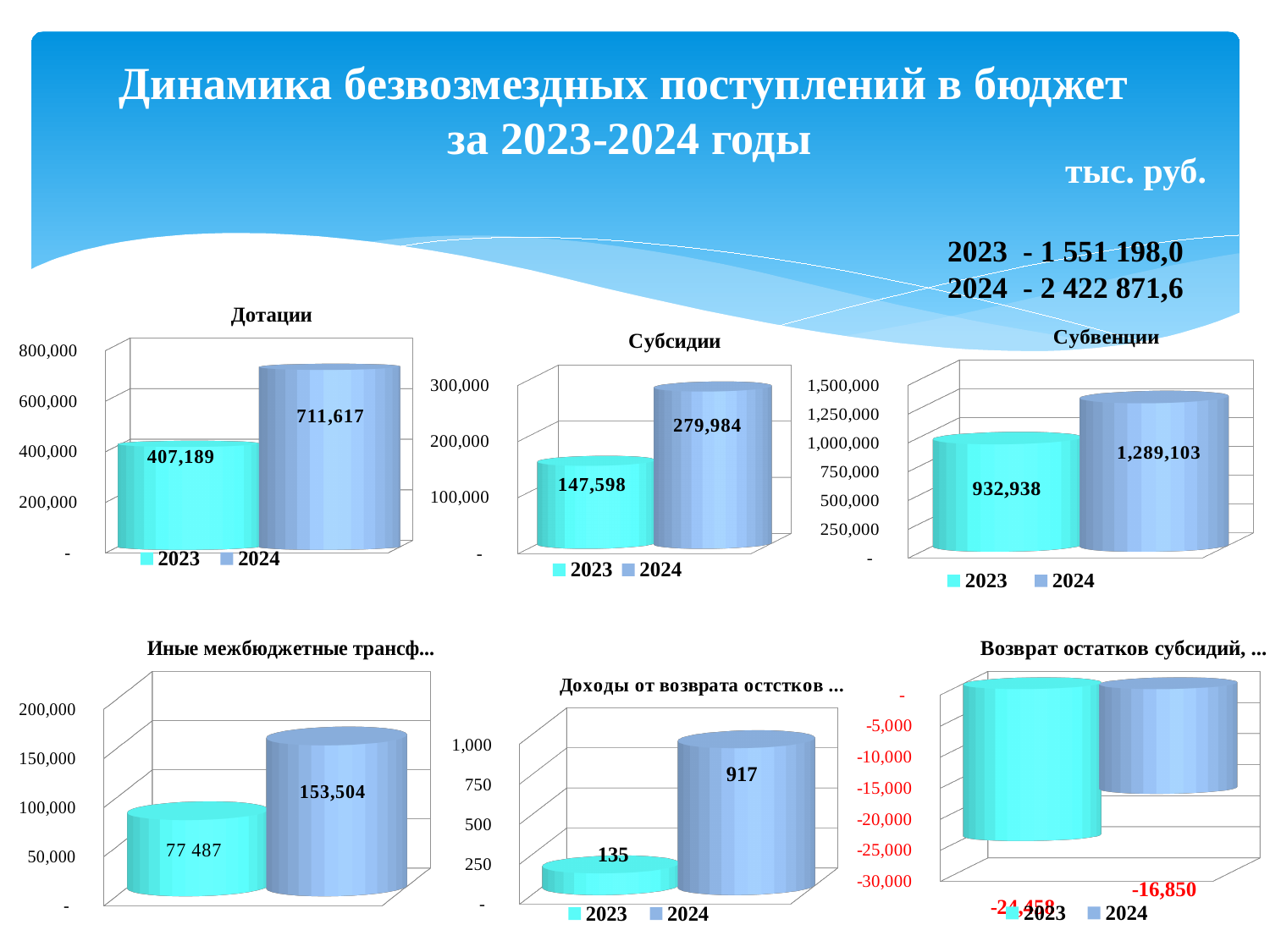
In the "Субвенции" chart, which year has the higher value, 2023 or 2024? 2024 In the "Субвенции" chart, what is the value for 2024? 1,289,103 In the "Дотации" chart, what is the value for 2024? 711,617 How many series does the legend of the "Дотации" chart list? 2 In the "Доходы от возврата остстков ..." chart, which year has the lowest value? 2023 What kind of chart is the "Субсидии" chart? bar chart In the "Дотации" chart, what is the value for 2023? 407,189 In the "Субсидии" chart, what is the difference between the 2024 and 2023 values? 132,386 In the "Доходы от возврата остстков ..." chart, what is the difference between the 2024 and 2023 values? 782 In the "Возврат остатков субсидий, ..." chart, what is the value for 2024? -16,850 In the "Иные межбюджетные трансф..." chart, what is the value for 2023? 77 487 In the "Субсидии" chart, what is the value for 2023? 147,598